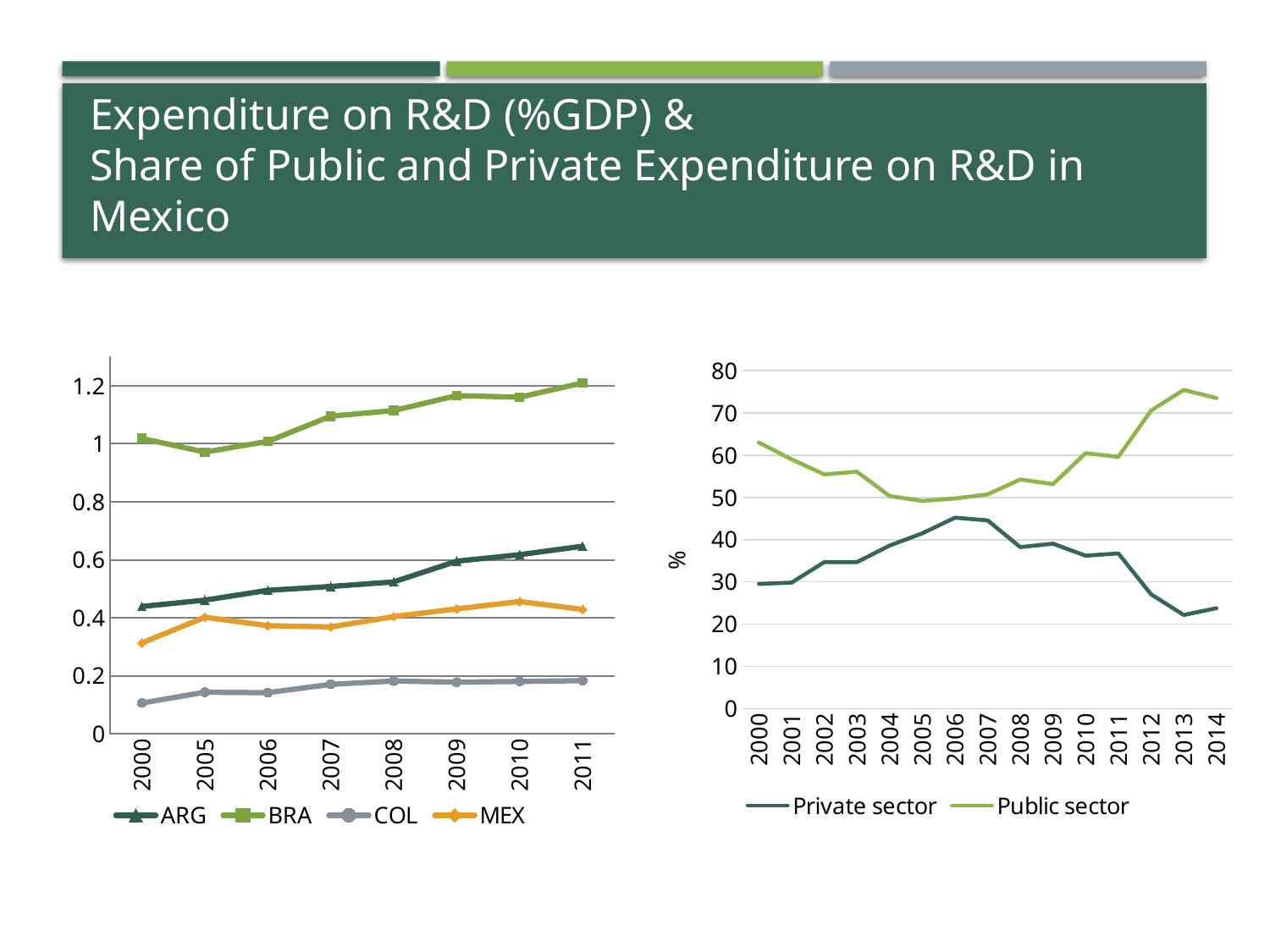
In the left chart, which country has the lowest R&D expenditure in 2000? COL How many years are shown on the x axis of the left chart? 8 In the right chart, which series is larger in 2014, Private sector or Public sector? Public sector In the left chart, which country has the highest R&D expenditure in 2011? BRA In the left chart, is the value for ARG in 2011 greater or less than 0.6? greater In the right chart, is the Public sector value in 2013 greater or less than 70? greater In the left chart, is the value for COL in 2000 greater or less than 0.2? less In the left chart, does the COL line rise or fall from 2000 to 2011? rise How many series does the legend of the right chart list? 2 How many years are shown on the x axis of the right chart? 15 How many series does the legend of the left chart list? 4 What kind of chart is the left chart on the slide? line chart